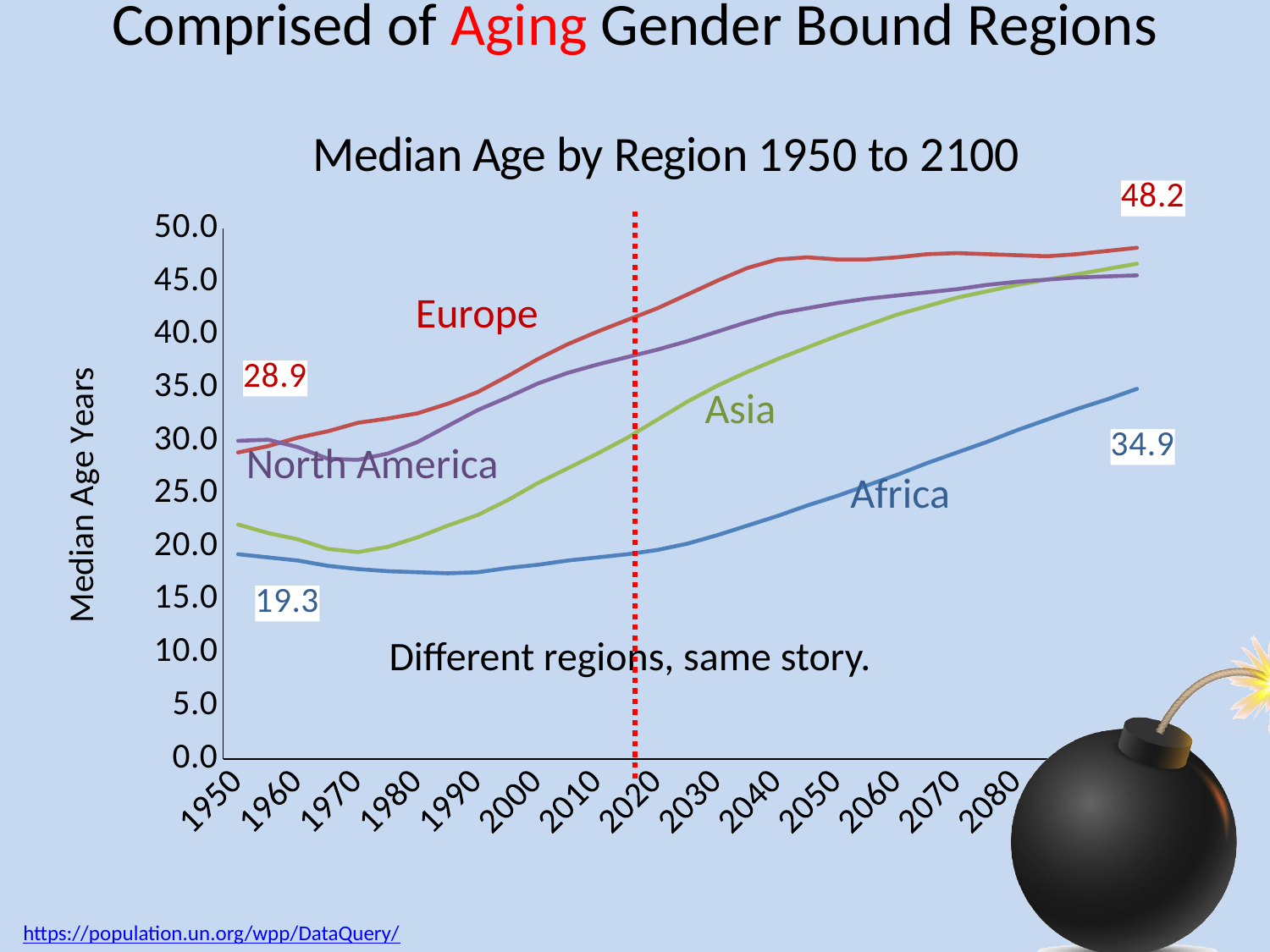
What is the median age for Europe in 1950 according to the data label? 28.9 By how much does Europe's median age increase from 1950 to 2100, based on the labelled values? 19.3 What is the title of the chart? Median Age by Region 1950 to 2100 How many regions are plotted as lines on the chart? 4 Which region has the highest median age at the end of the chart? Europe What is the median age for Africa in 1950 according to the data label? 19.3 Is the median age for Asia in 1950 greater or less than 25.0? less What is the median age for Europe in 2100 according to the data label? 48.2 Which region has the lowest median age throughout the chart? Africa What is the median age for Africa in 2100 according to the data label? 34.9 What is the label on the vertical axis of the chart? Median Age Years What type of chart is shown on the slide? Line chart